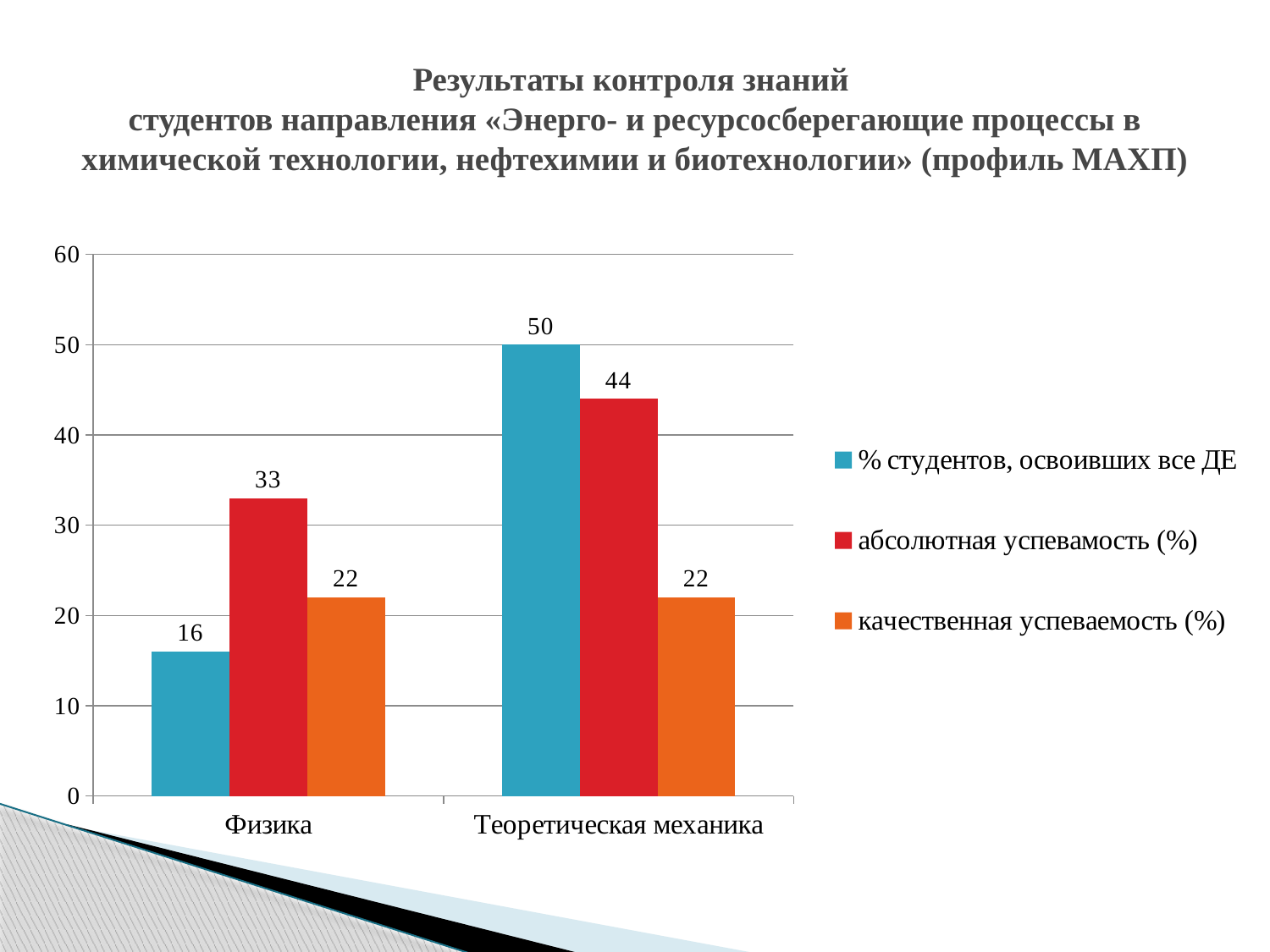
What is the difference between «абсолютная успевамость (%)» for Теоретическая механика and for Физика? 11 How many categories are shown on the x axis? 2 What kind of chart is shown on the slide? bar chart Which category has the lowest value for «% студентов, освоивших все ДЕ»? Физика What is the value of «абсолютная успевамость (%)» for Теоретическая механика? 44 What is the value of «% студентов, освоивших все ДЕ» for Теоретическая механика? 50 Is the value of «% студентов, освоивших все ДЕ» for Теоретическая механика greater or less than 40? greater How many series does the legend list? 3 Which category has the highest value for «абсолютная успевамость (%)»? Теоретическая механика What is the value of «качественная успеваемость (%)» for Физика? 22 What is the value of «% студентов, освоивших все ДЕ» for Физика? 16 Which is larger: «% студентов, освоивших все ДЕ» for Физика or «абсолютная успевамость (%)» for Физика? абсолютная успевамость (%) for Физика